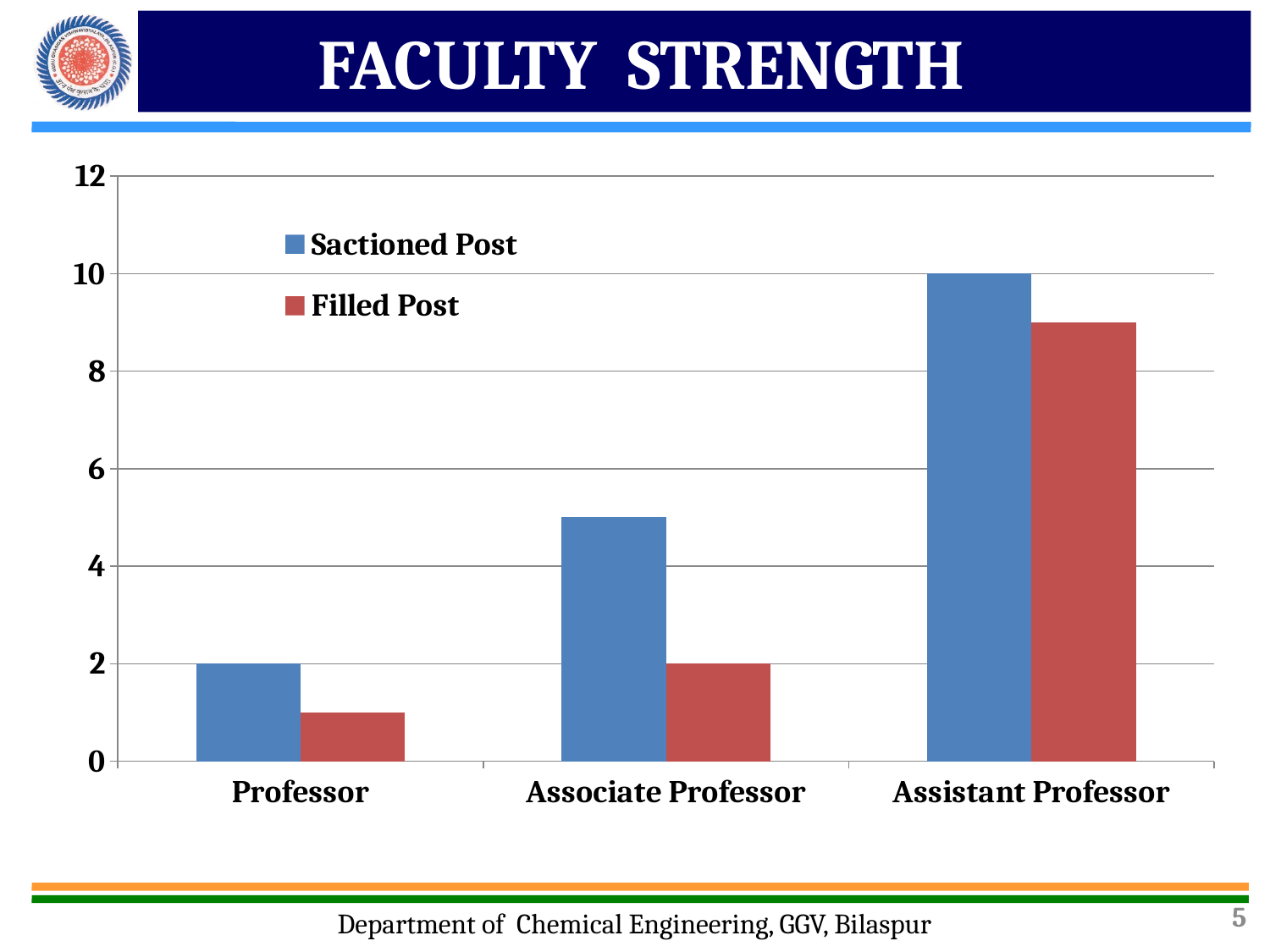
For Associate Professor, which is larger: Sactioned Post or Filled Post? Sactioned Post What type of chart is shown on the slide? bar chart How many series does the legend list? 2 Which category has the lowest Filled Post value? Professor How many categories are shown on the x axis? 3 Is the Filled Post value for Assistant Professor greater or less than 8? greater What is the Sactioned Post value for Assistant Professor? 10 What is the Sactioned Post value for Professor? 2 Is the Sactioned Post value for Associate Professor greater or less than 4? greater What is the difference between the Sactioned Post values for Assistant Professor and Professor? 8 Which category has the highest Sactioned Post value? Assistant Professor What is the Filled Post value for Associate Professor? 2